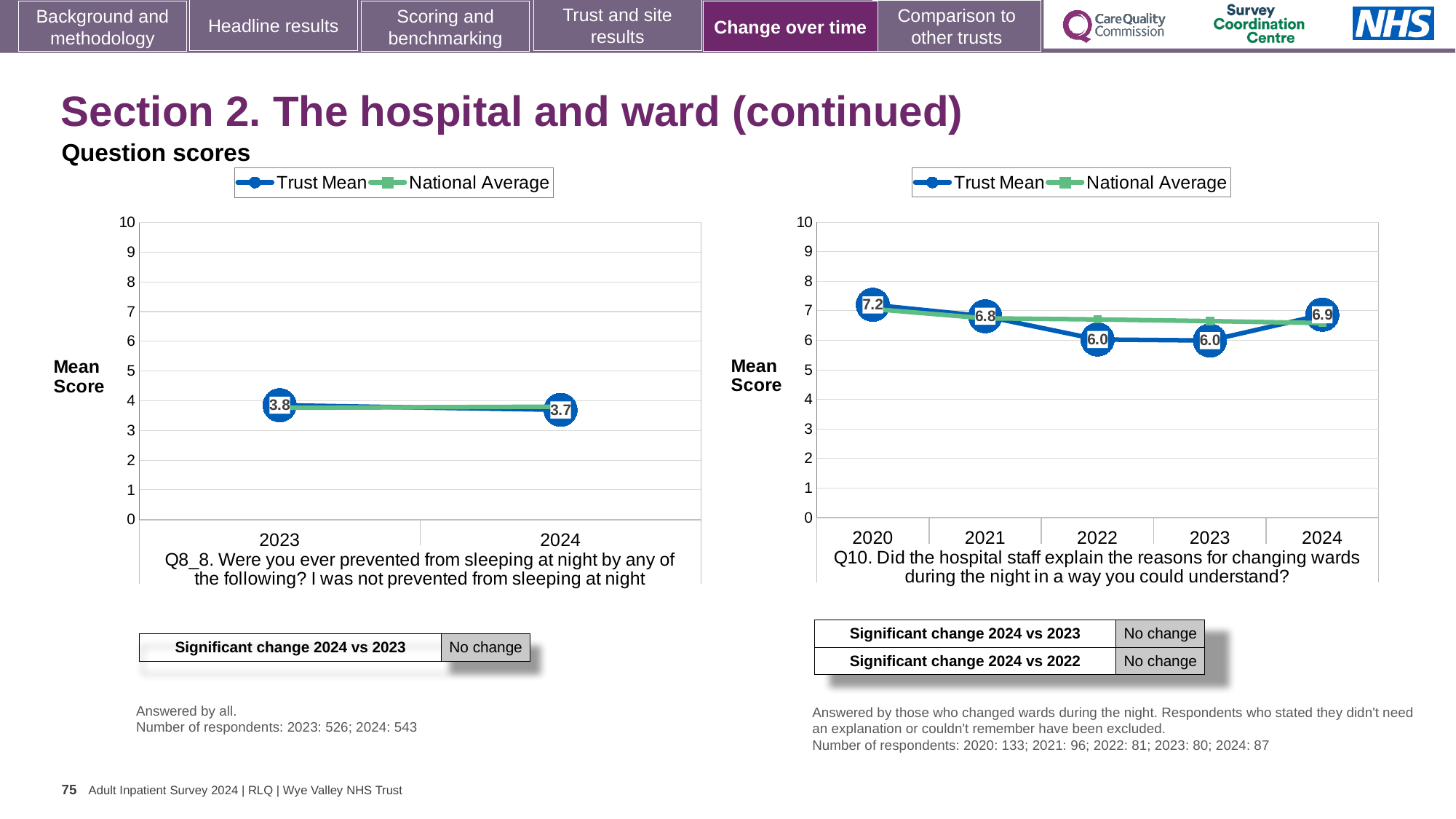
In the Q8_8 chart on the left, what is the Trust Mean score for 2023? 3.8 In the Q8_8 chart on the left, how many years are shown on the x axis? 2 In the Q10 chart on the right, which year has the highest Trust Mean score? 2020 In the Q10 chart on the right, what is the Trust Mean score for 2022? 6.0 In the Q8_8 chart on the left, what is the Trust Mean score for 2024? 3.7 In the Q10 chart on the right, how many years are shown on the x axis? 5 How many series does the legend of the Q10 chart on the right list? 2 In the Q10 chart on the right, is the Trust Mean score for 2021 greater or less than 6? greater What kind of chart is the Q8_8 chart on the left? Line chart In the Q8_8 chart on the left, what is the difference between the Trust Mean scores for 2023 and 2024? 0.1 In the Q10 chart on the right, what is the Trust Mean score for 2020? 7.2 In the Q10 chart on the right, what is the difference between the Trust Mean scores for 2020 and 2023? 1.2